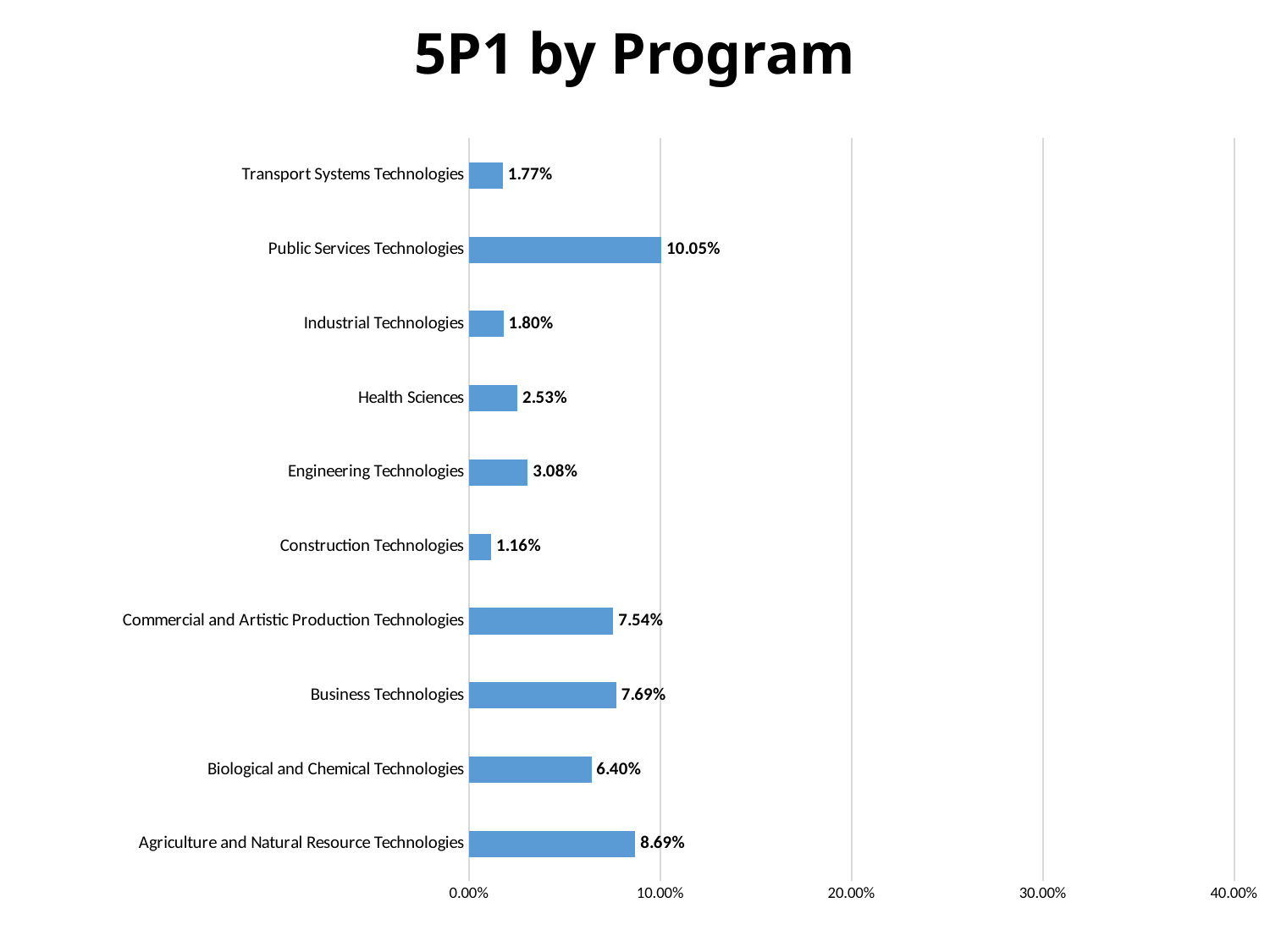
What is the difference between Business Technologies and Biological and Chemical Technologies? 1.29% What kind of chart is shown on the slide? Bar chart What is the value for Public Services Technologies? 10.05% How many programs are shown in the chart? 10 Which program has the lowest value? Construction Technologies Is the value for Commercial and Artistic Production Technologies greater or less than 10.00%? less What is the difference between Public Services Technologies and Agriculture and Natural Resource Technologies? 1.36% Which program has the highest value? Public Services Technologies What is the value for Agriculture and Natural Resource Technologies? 8.69% Which is larger, Engineering Technologies or Health Sciences? Engineering Technologies What is the value for Health Sciences? 2.53% What is the title of the chart? 5P1 by Program